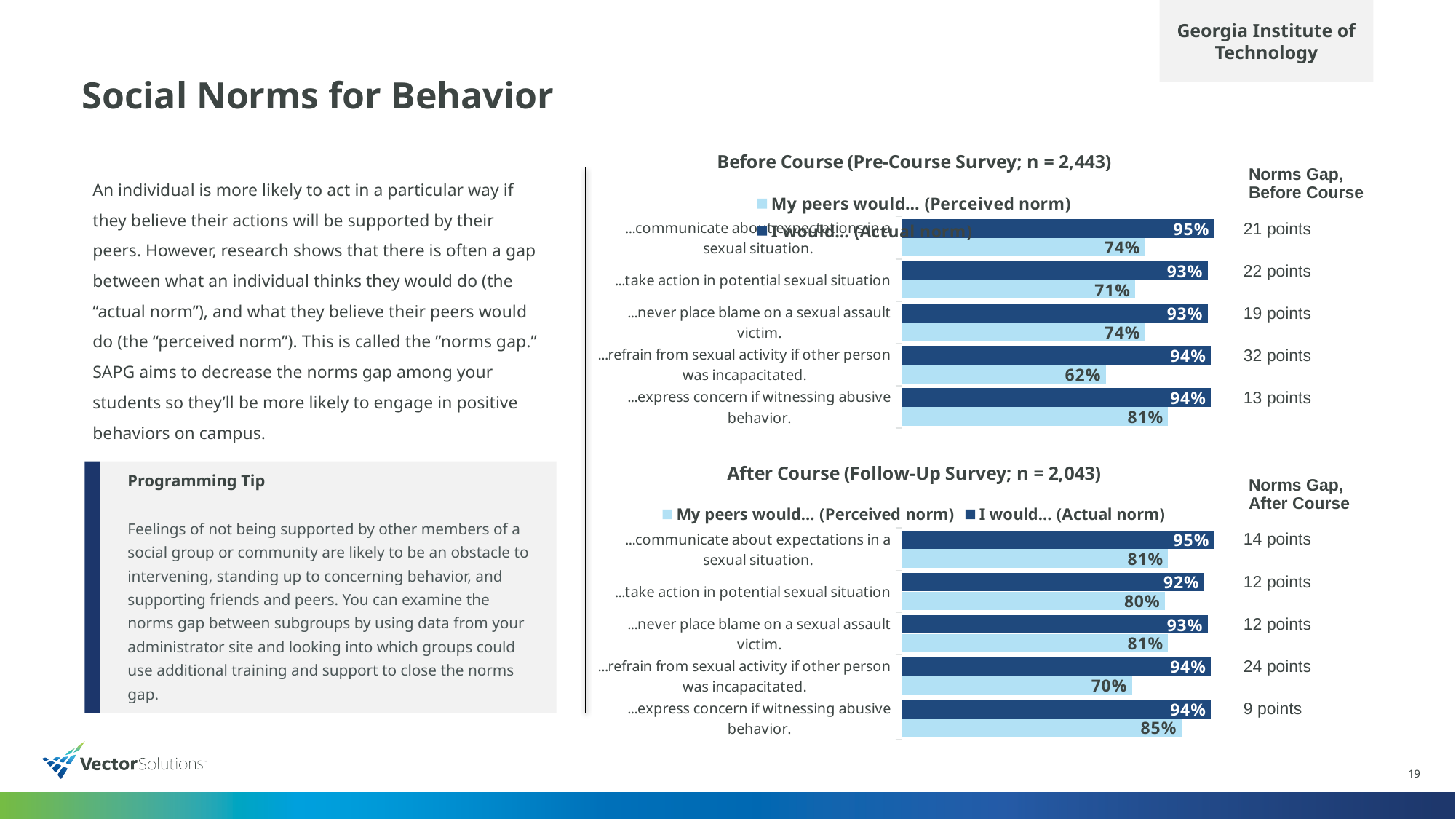
In the Before Course chart, what is the difference between the "I would... (Actual norm)" and "My peers would... (Perceived norm)" values for "...take action in potential sexual situation"? 22 percentage points In the Before Course chart, which category has the lowest "My peers would... (Perceived norm)" value? ...refrain from sexual activity if other person was incapacitated. In the After Course chart, what is the value for "I would... (Actual norm)" for "...take action in potential sexual situation"? 92% What type of chart is the After Course chart? Bar chart In the Before Course chart, what is the value for "My peers would... (Perceived norm)" for "...refrain from sexual activity if other person was incapacitated"? 62% In the Before Course chart, what is the value for "I would... (Actual norm)" for "...communicate about expectations in a sexual situation"? 95% In the After Course chart, which category has the highest "My peers would... (Perceived norm)" value? ...express concern if witnessing abusive behavior. How many series does the legend of the After Course chart list? 2 In the After Course chart, what is the difference between the "I would... (Actual norm)" and "My peers would... (Perceived norm)" values for "...refrain from sexual activity if other person was incapacitated"? 24 percentage points How many categories are shown in the Before Course chart? 5 In the After Course chart, what is the value for "My peers would... (Perceived norm)" for "...express concern if witnessing abusive behavior"? 85% In the After Course chart, which is larger for "...never place blame on a sexual assault victim": the "I would... (Actual norm)" value or the "My peers would... (Perceived norm)" value? I would... (Actual norm)